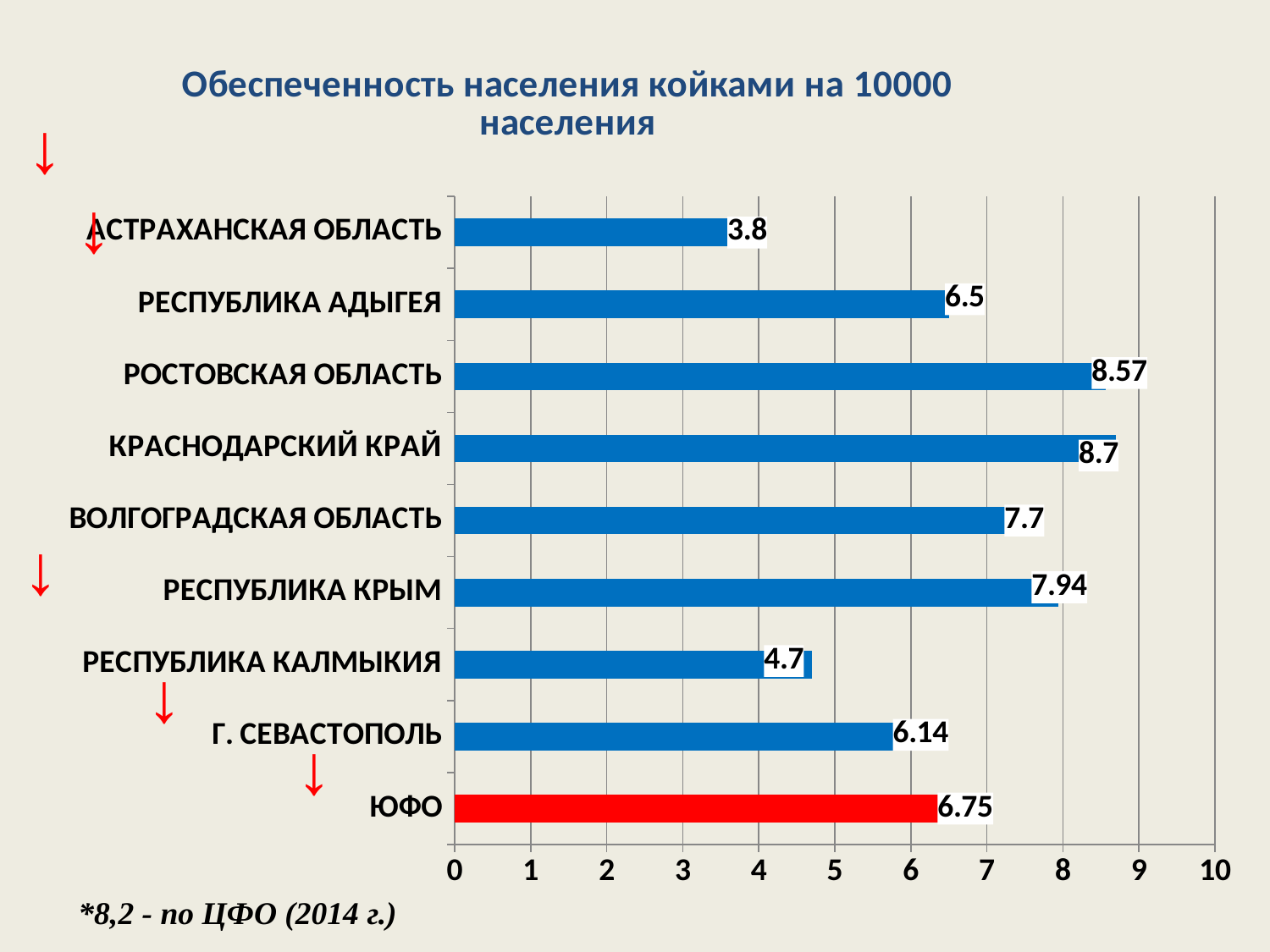
What is the value for Республика Крым? 7.94 What kind of chart is shown on the slide? bar chart Which category has the highest value? Краснодарский край What is the title of the chart? Обеспеченность населения койками на 10000 населения What is the value for ЮФО? 6.75 Is the value for Республика Калмыкия greater or less than 5? less Which bar is coloured red instead of blue? ЮФО Which is larger, the value for Волгоградская область or the value for г. Севастополь? Волгоградская область How many categories are shown on the chart? 9 Which category has the lowest value? Астраханская область What is the difference between the values for Ростовская область and Республика Адыгея? 2.07 What is the value for Астраханская область? 3.8